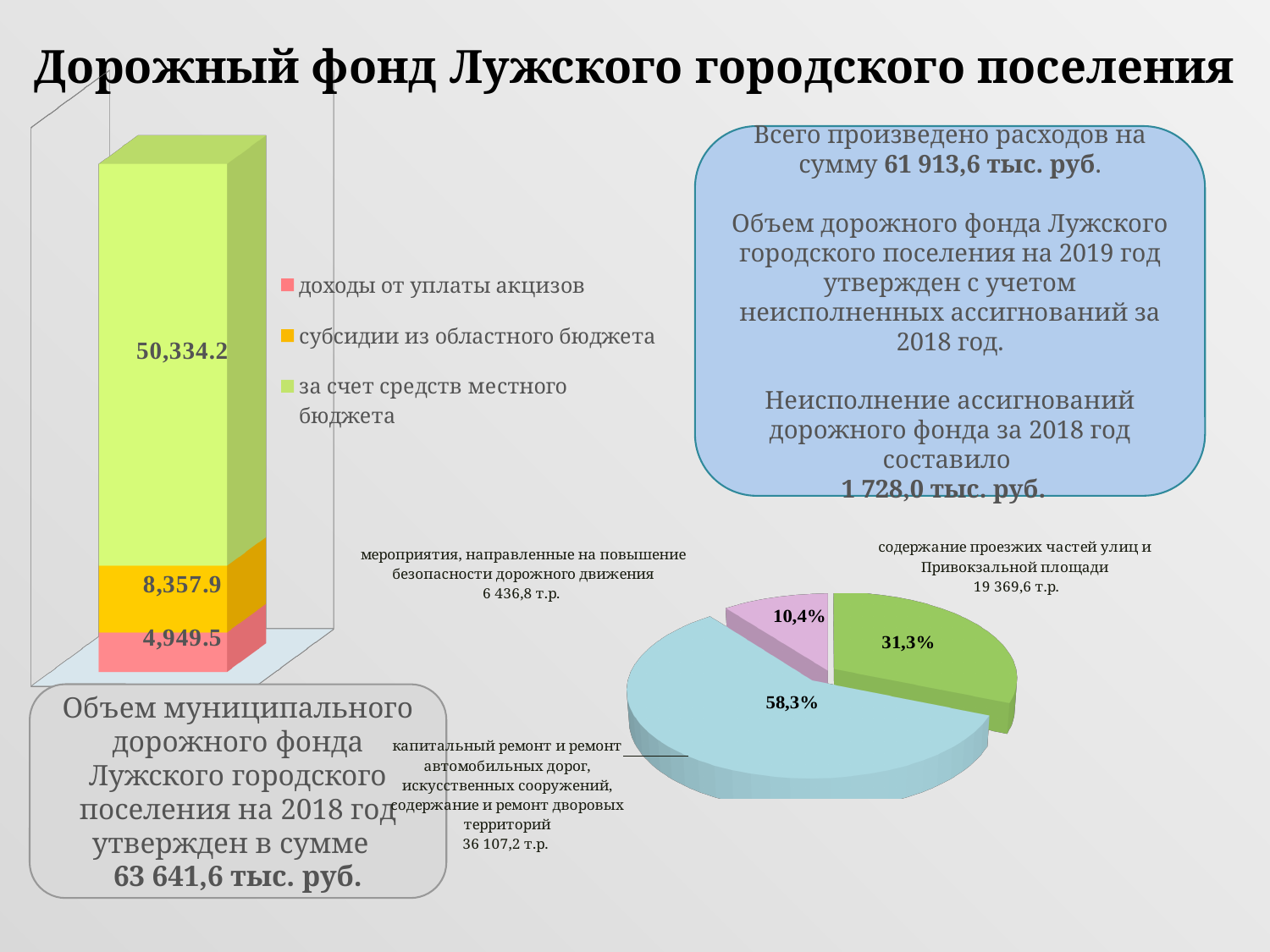
In the stacked bar chart on the left, what is the value for 'субсидии из областного бюджета'? 8,357.9 In the stacked bar chart on the left, what is the total of the three segments? 63,641.6 In the stacked bar chart on the left, which series has the largest value? за счет средств местного бюджета In the pie chart on the right, what amount is shown for 'мероприятия, направленные на повышение безопасности дорожного движения'? 6 436,8 т.р. In the pie chart on the right, what share is shown for 'содержание проезжих частей улиц и Привокзальной площади'? 31,3% In the pie chart on the right, which category has the largest slice? капитальный ремонт и ремонт автомобильных дорог, искусственных сооружений, содержание и ремонт дворовых территорий In the stacked bar chart on the left, what is the value for 'доходы от уплаты акцизов'? 4,949.5 What kind of chart is shown on the right side of the slide? pie chart In the stacked bar chart on the left, what is the value for 'за счет средств местного бюджета'? 50,334.2 How many series does the legend of the stacked bar chart on the left list? 3 In the stacked bar chart on the left, what is the difference between 'субсидии из областного бюджета' and 'доходы от уплаты акцизов'? 3,408.4 In the stacked bar chart on the left, which series has the smallest value? доходы от уплаты акцизов